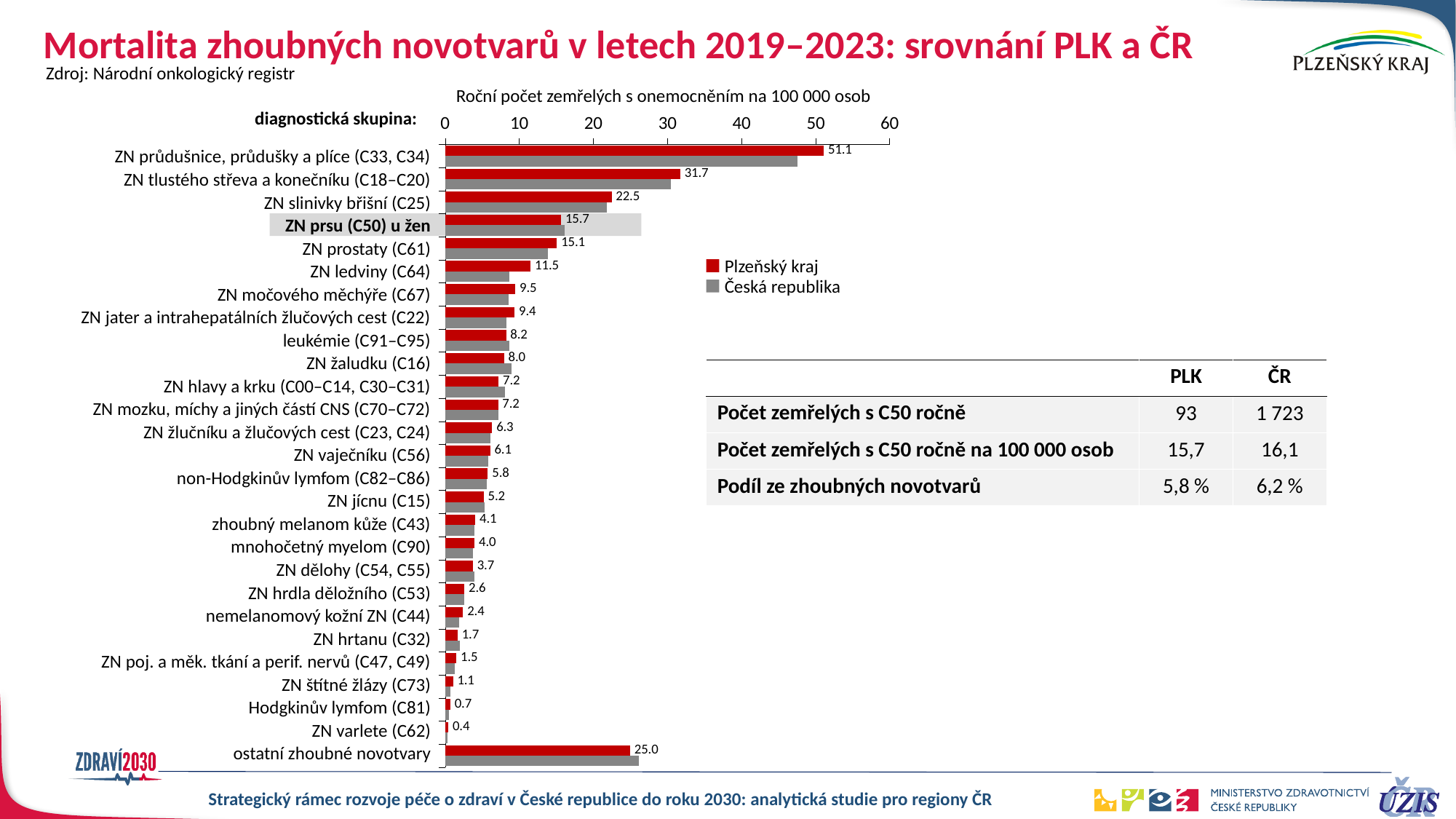
What type of chart is shown on the slide? bar chart Which is larger for Plzeňský kraj: ZN slinivky břišní (C25) or ZN prostaty (C61)? ZN slinivky břišní (C25) How many diagnostic groups are shown on the chart? 27 Is the Česká republika value for ZN průdušnice, průdušky a plíce (C33, C34) greater or less than 40? greater Which diagnostic group has the highest value for Plzeňský kraj? ZN průdušnice, průdušky a plíce (C33, C34) How many series does the chart legend list? 2 What is the value for Plzeňský kraj for ZN prsu (C50) u žen? 15.7 Which diagnostic group has the lowest value for Plzeňský kraj? ZN varlete (C62) What is the value for Plzeňský kraj for ZN průdušnice, průdušky a plíce (C33, C34)? 51.1 What is the value for Plzeňský kraj for ZN ledviny (C64)? 11.5 Which colour represents Plzeňský kraj in the chart? red What is the difference between the Plzeňský kraj values for ZN průdušnice, průdušky a plíce (C33, C34) and ZN tlustého střeva a konečníku (C18–C20)? 19.4